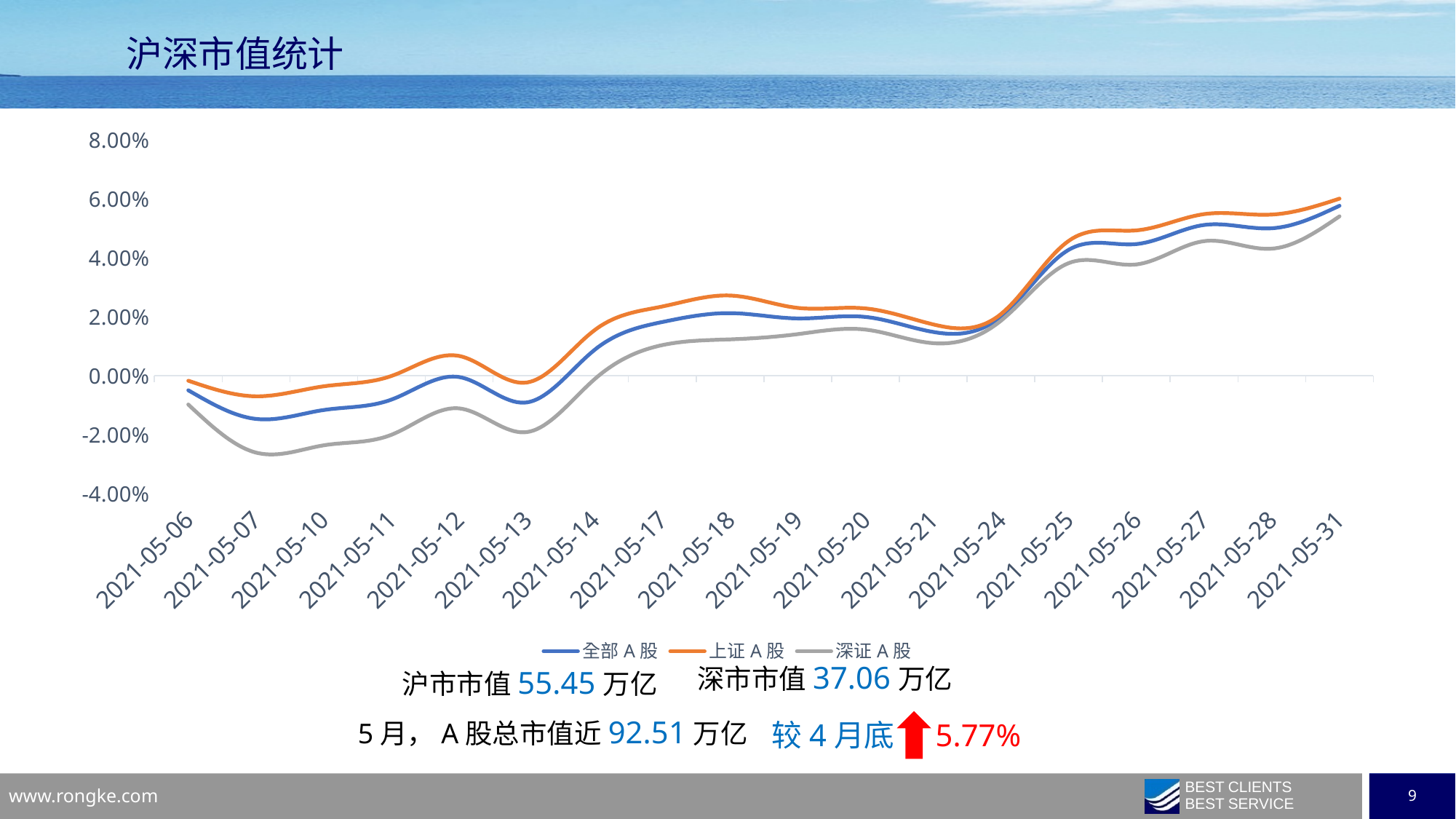
Is the value for 全部A股 on 2021-05-18 greater or less than 0.00%? greater Overall, do the values for 全部A股 rise or fall from 2021-05-06 to 2021-05-31? rise What is the title of the slide containing the chart? 沪深市值统计 What are the three series listed in the chart legend? 全部A股, 上证A股, 深证A股 How many dates are shown on the x axis of the chart? 18 Which series has the highest value on 2021-05-31? 上证A股 Is the value for 深证A股 on 2021-05-07 greater or less than -2.00%? less Is the value for 深证A股 on 2021-05-13 greater or less than 0.00%? less What kind of chart is shown on the slide? line chart On 2021-05-31, which series has the higher value, 上证A股 or 深证A股? 上证A股 How many series does the legend list? 3